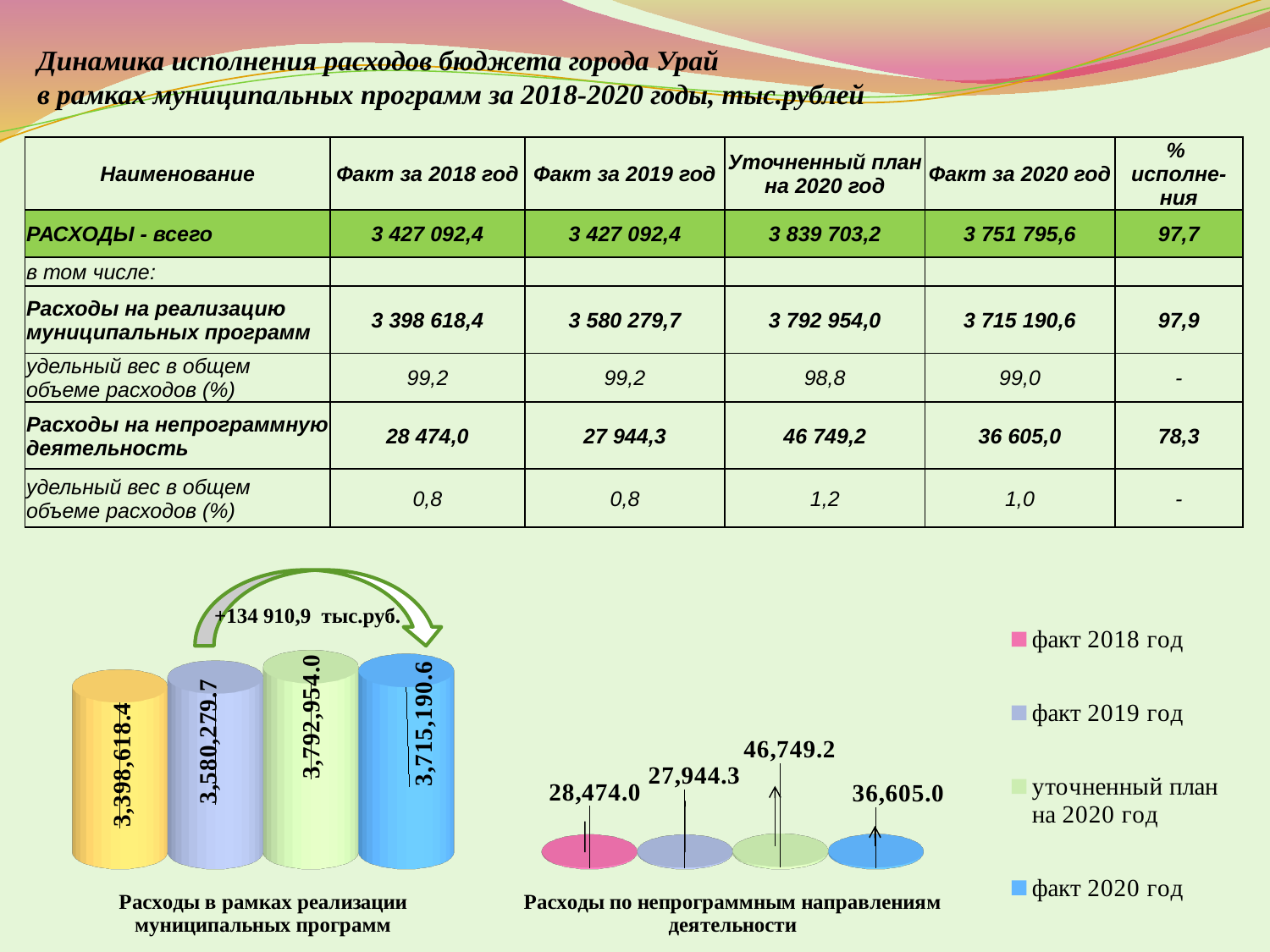
What increase is shown by the arrow above the bars for Расходы в рамках реализации муниципальных программ? +134 910,9 тыс.руб. In the chart, what is the value for факт 2018 год in the group Расходы в рамках реализации муниципальных программ? 3,398,618.4 In the chart, what is the value for уточненный план на 2020 год in the group Расходы в рамках реализации муниципальных программ? 3,792,954.0 In the chart, what is the value for факт 2020 год in the group Расходы по непрограммным направлениям деятельности? 36,605.0 In the chart, what is the difference between уточненный план на 2020 год and факт 2020 год in the group Расходы по непрограммным направлениям деятельности? 10,144.2 How many series does the chart legend list? 4 In the chart, which is larger in the group Расходы в рамках реализации муниципальных программ: факт 2019 год or факт 2020 год? факт 2020 год In the chart, which series has the highest value in the group Расходы по непрограммным направлениям деятельности? уточненный план на 2020 год In the chart, which series has the lowest value in the group Расходы в рамках реализации муниципальных программ? факт 2018 год What kind of chart is shown at the bottom of the slide? bar chart In the chart, what is the value for факт 2019 год in the group Расходы по непрограммным направлениям деятельности? 27,944.3 How many category groups are plotted in the chart? 2